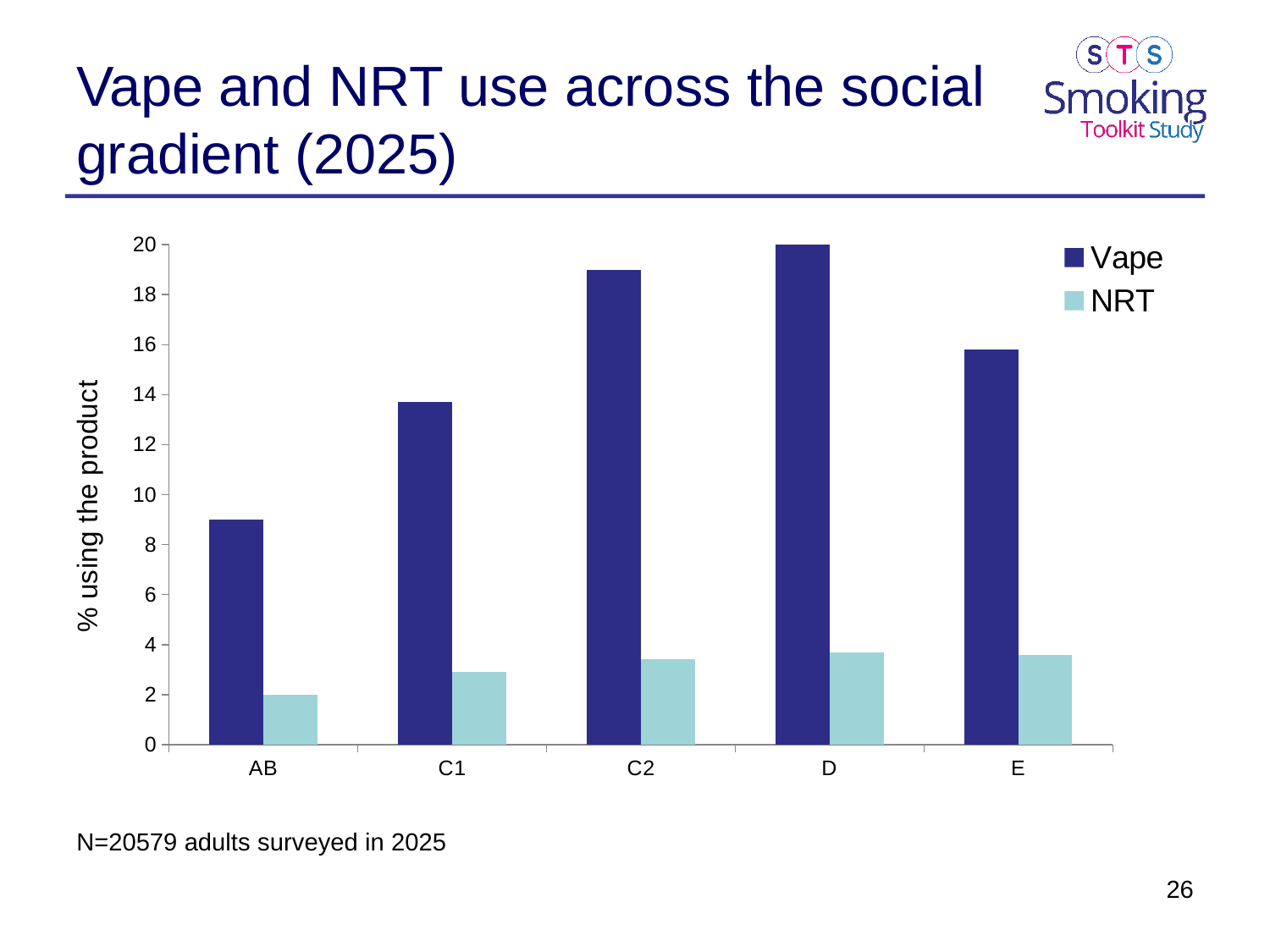
Which is larger, the Vape value for C2 or the Vape value for E? C2 Which social grade has the lowest NRT value? AB What kind of chart is shown on the slide? bar chart Is the Vape value for C1 greater or less than 12? greater How many series does the legend list? 2 Which social grade has the highest Vape value? D Is the NRT value for C2 greater or less than 4? less Is the Vape value for E greater or less than 16? less What is the label on the y axis? % using the product Which social grade has the lowest Vape value? AB How many social grade categories are shown on the x axis? 5 Do the Vape values rise or fall from AB to D along the x axis? rise